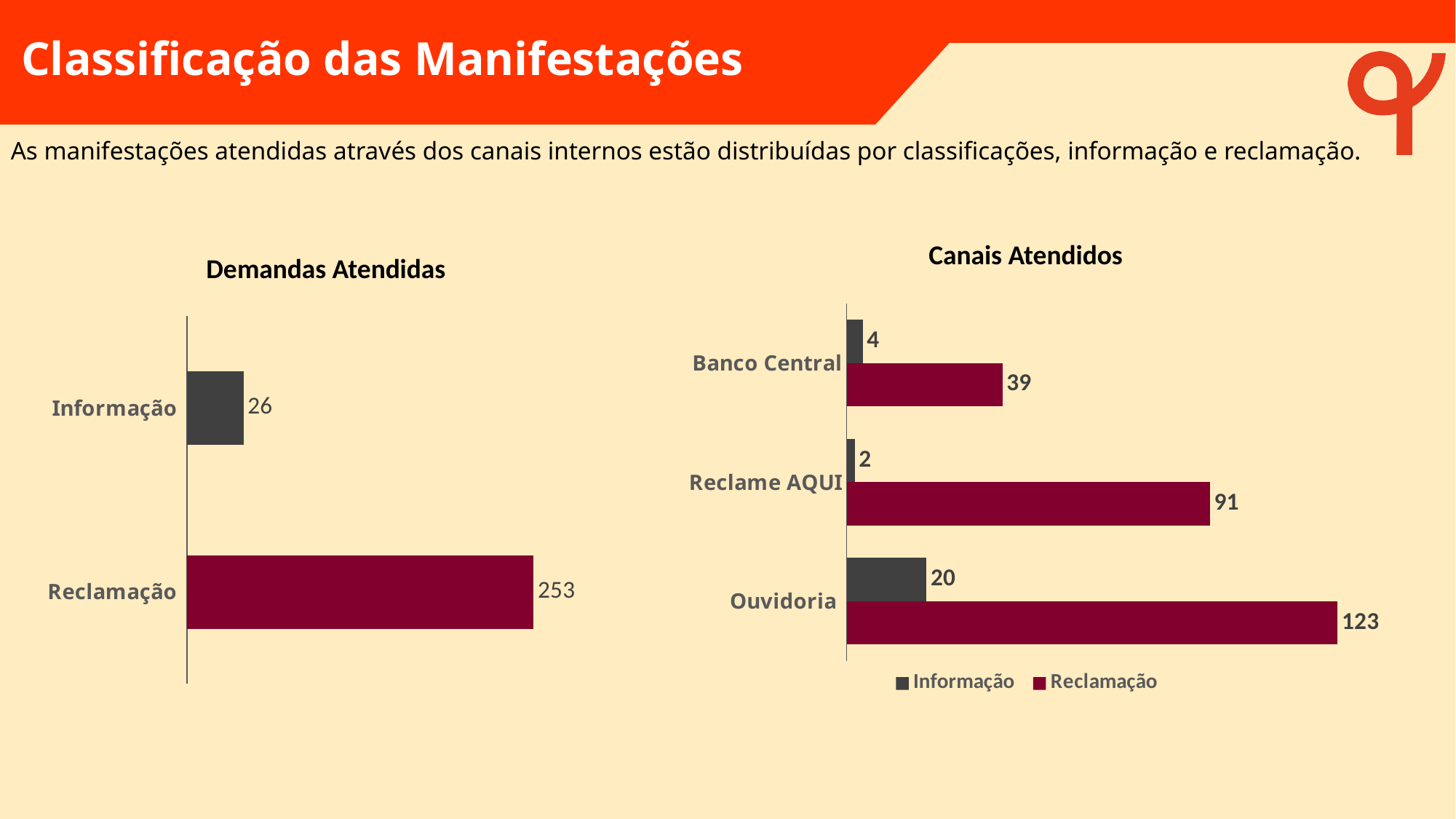
In the 'Demandas Atendidas' chart, what is the difference between Reclamação and Informação? 227 How many series does the legend of the 'Canais Atendidos' chart list? 2 In the 'Demandas Atendidas' chart, what is the value for Informação? 26 In the 'Canais Atendidos' chart, what is the difference between the Reclamação values for Ouvidoria and Banco Central? 84 In the 'Canais Atendidos' chart, which channel has the highest Reclamação value? Ouvidoria In the 'Demandas Atendidas' chart, what is the value for Reclamação? 253 In the 'Canais Atendidos' chart, what is the Reclamação value for Ouvidoria? 123 In the 'Canais Atendidos' chart, what is the Informação value for Banco Central? 4 In the 'Demandas Atendidas' chart, which category has the highest value? Reclamação In the 'Canais Atendidos' chart, what is the Reclamação value for Reclame AQUI? 91 What kind of chart is the 'Canais Atendidos' chart? Bar chart In the 'Canais Atendidos' chart, which channel has the lowest Informação value? Reclame AQUI